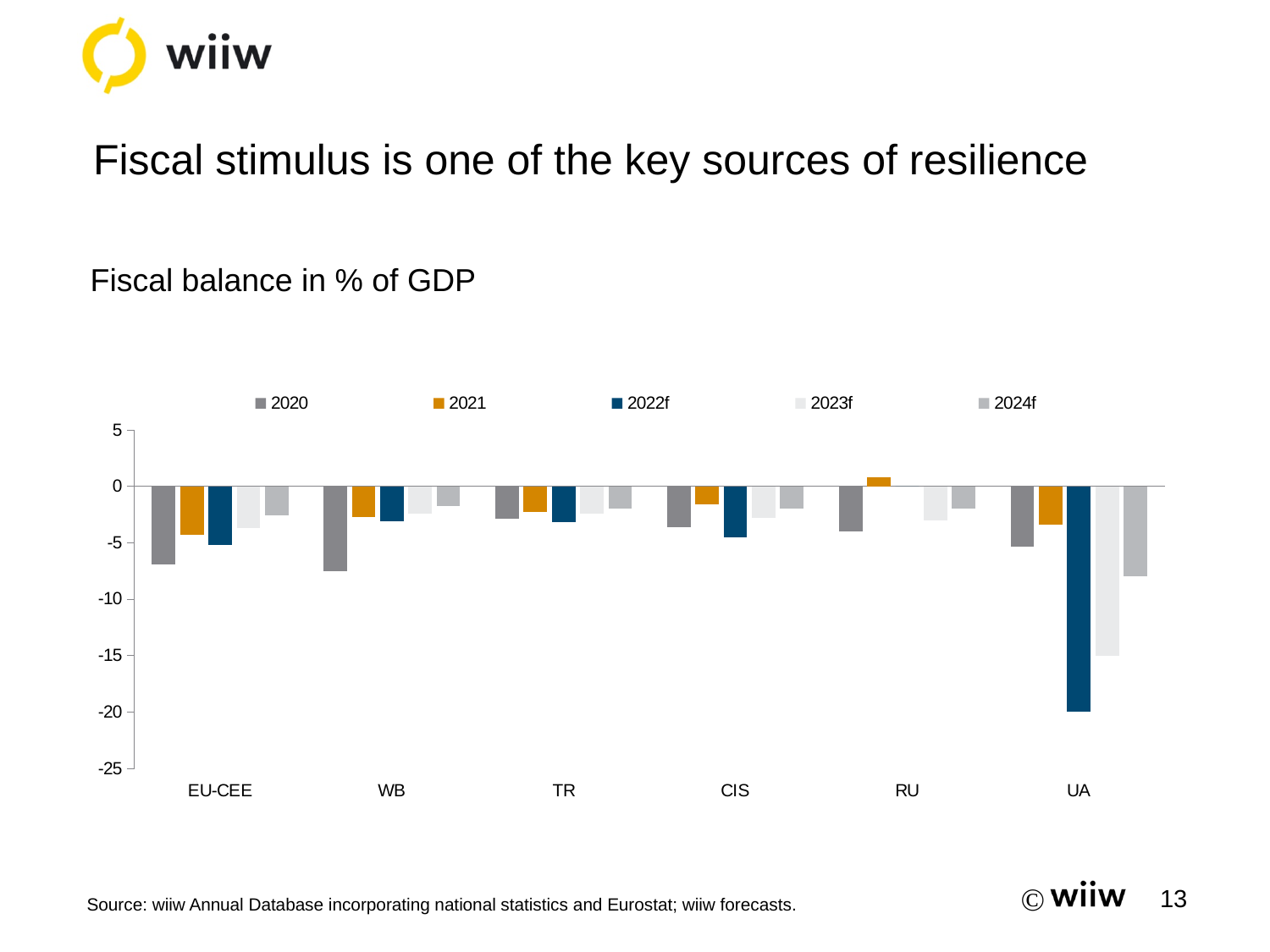
How many series does the legend list? 5 Which category and year has the only positive fiscal balance shown? RU, 2021 How many categories (regions/countries) are shown on the x axis? 6 Which category has the lowest bar in the chart? UA For UA, do the values rise or fall from 2022f to 2024f? rise Is the 2022f value for UA greater or less than -15? less What kind of chart is shown on the slide? bar chart For UA, which is lower, the 2022f value or the 2023f value? 2022f Is the 2020 value for EU-CEE greater or less than -5? less What is the subtitle describing the chart's measure? Fiscal balance in % of GDP Is the 2023f value for UA greater or less than -10? less